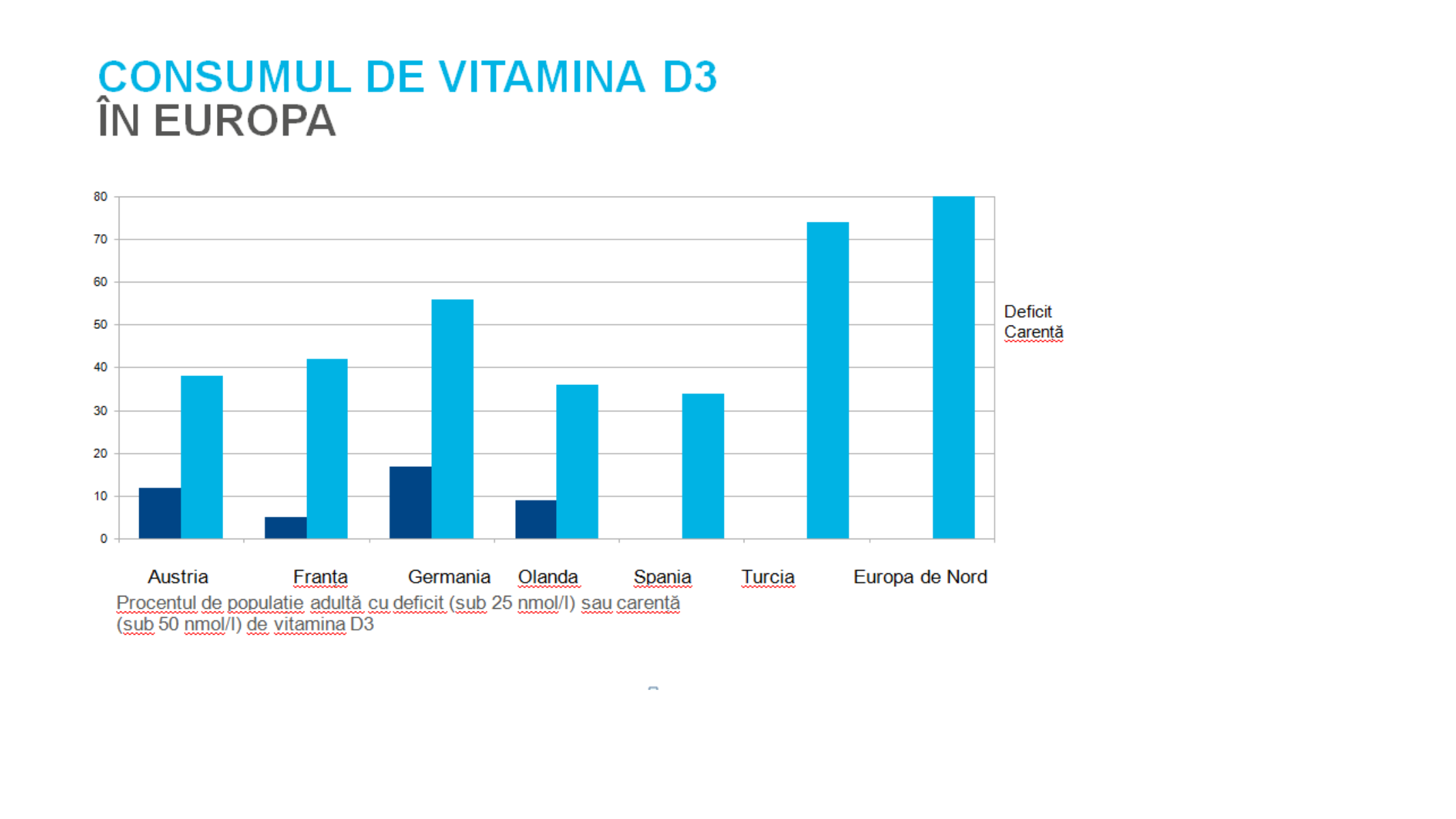
How many series does the legend list? 2 Is the Carență value for Germania greater or less than 50? greater Which legend entry is shown in dark blue? Deficit Is the Carență value for Turcia greater or less than 70? greater Is the Carență value for Spania greater or less than 30? greater Which is larger, the Carență value for Germania or the Carență value for Franta? Germania How many countries or regions are shown on the x axis? 7 What kind of chart is shown on the slide? bar chart Which category has the highest Carență value? Europa de Nord Which category has the highest Deficit value? Germania